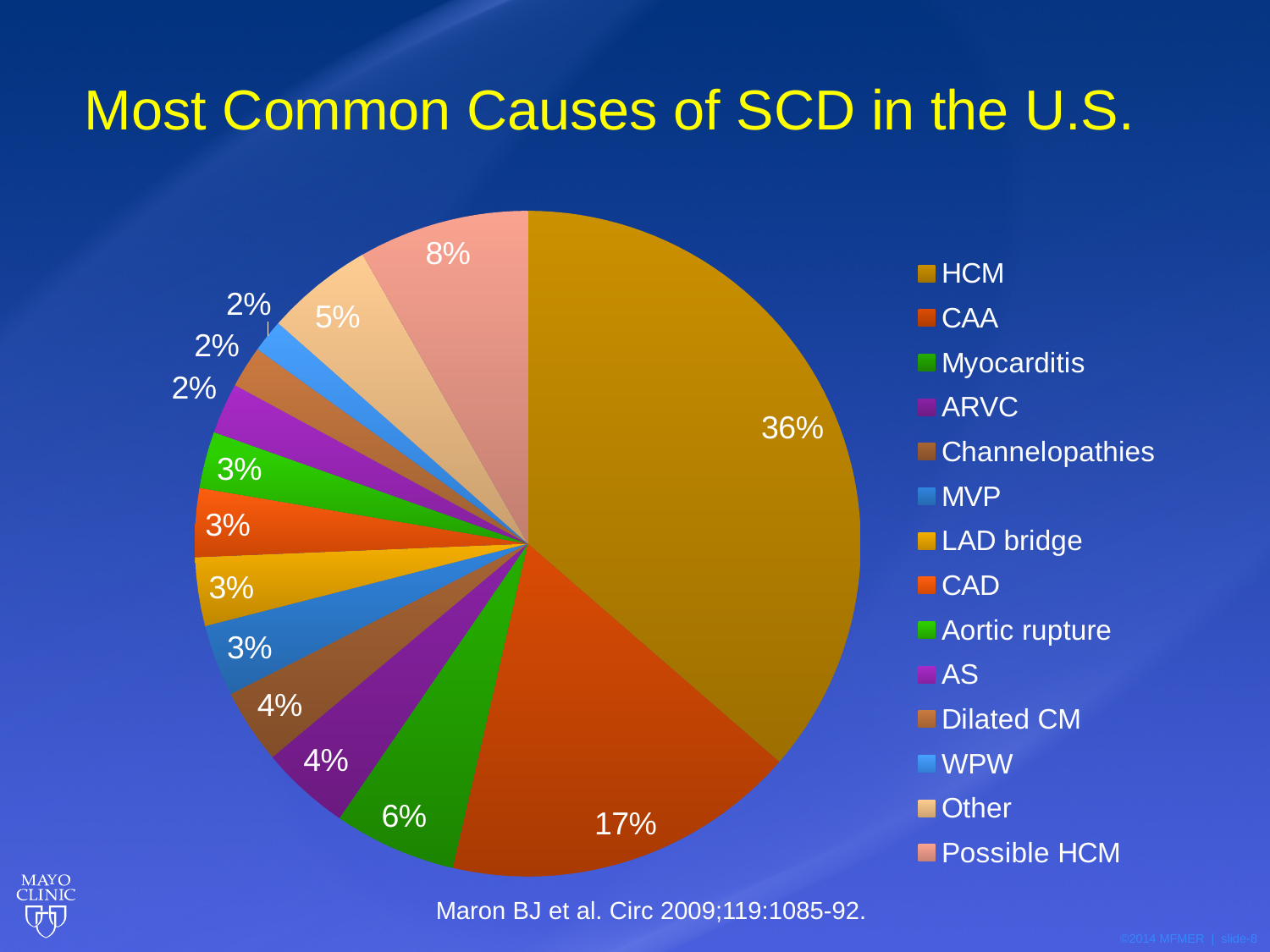
What percentage of the pie is Possible HCM? 8% What kind of chart is shown on the slide? pie chart Which is larger, the share for Possible HCM or the share for Myocarditis? Possible HCM How many categories does the legend list? 14 What is the difference in percentage points between HCM and CAA? 19 What percentage of the pie is CAA? 17% What percentage of the pie is Other? 5% What is the title of the chart? Most Common Causes of SCD in the U.S. What percentage of the pie is HCM? 36% What percentage of the pie is Myocarditis? 6% What is the combined share of HCM and Possible HCM? 44% Which category has the largest share of the pie? HCM